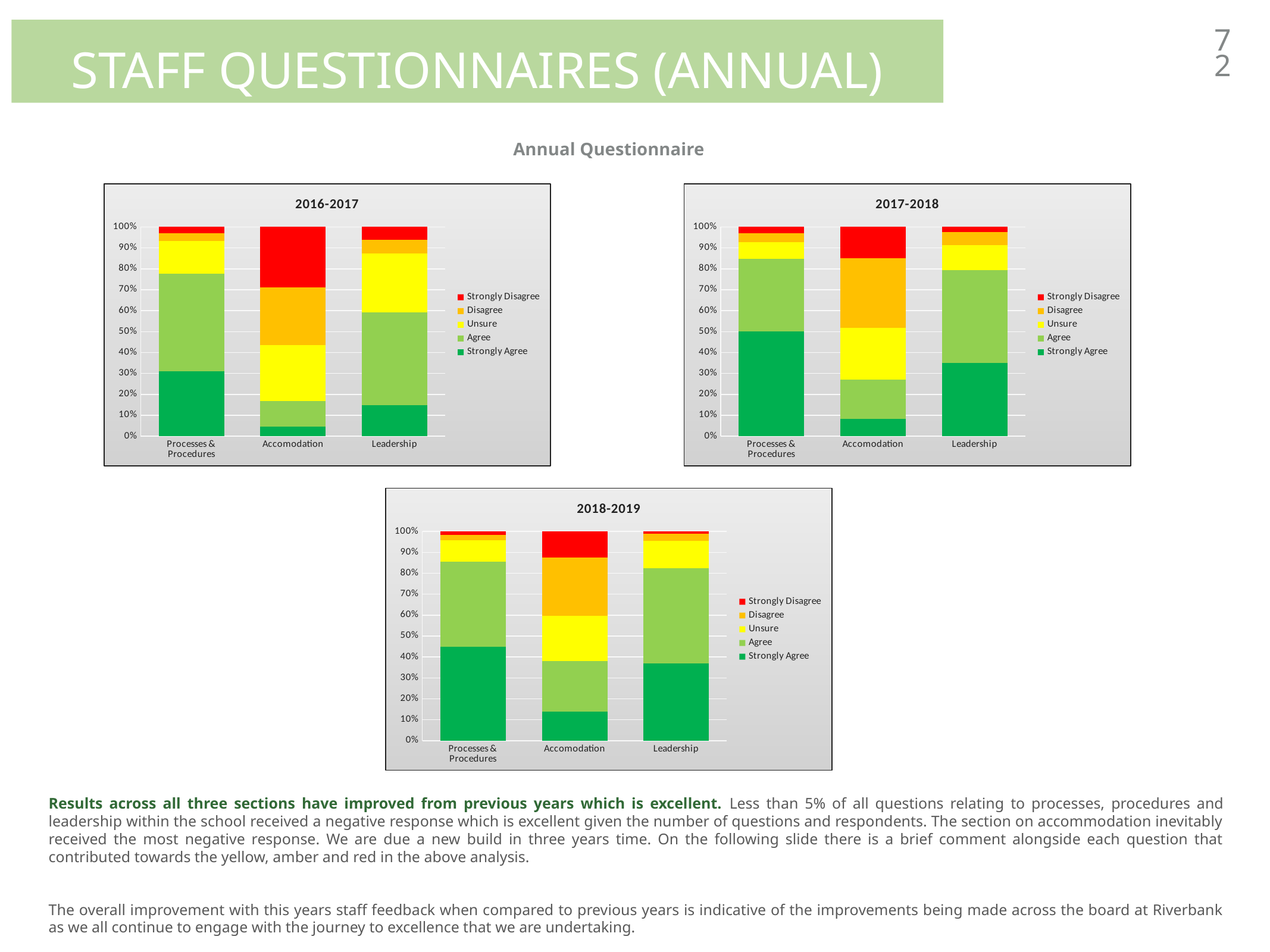
How many series does the legend of the 2018-2019 chart list? 5 In the 2017-2018 chart, is the Strongly Agree value for Leadership greater or less than 30%? greater In the 2018-2019 chart, is the Strongly Agree value for Processes & Procedures greater or less than 40%? greater What is the overall title shown above the three charts? Annual Questionnaire How many categories are shown on the x axis of the 2016-2017 chart? 3 In the 2016-2017 chart, is the Strongly Disagree segment larger for Accomodation or for Leadership? Accomodation In the 2016-2017 chart, is the Strongly Agree value for Accomodation greater or less than 10%? less In the 2017-2018 chart, which category has the smallest Strongly Agree segment? Accomodation In the 2017-2018 chart, which category has the largest Disagree segment? Accomodation What colour represents the Unsure series in the charts? Yellow What kind of chart is the 2016-2017 chart? Stacked bar chart In the 2018-2019 chart, which category has the largest Strongly Agree segment? Processes & Procedures